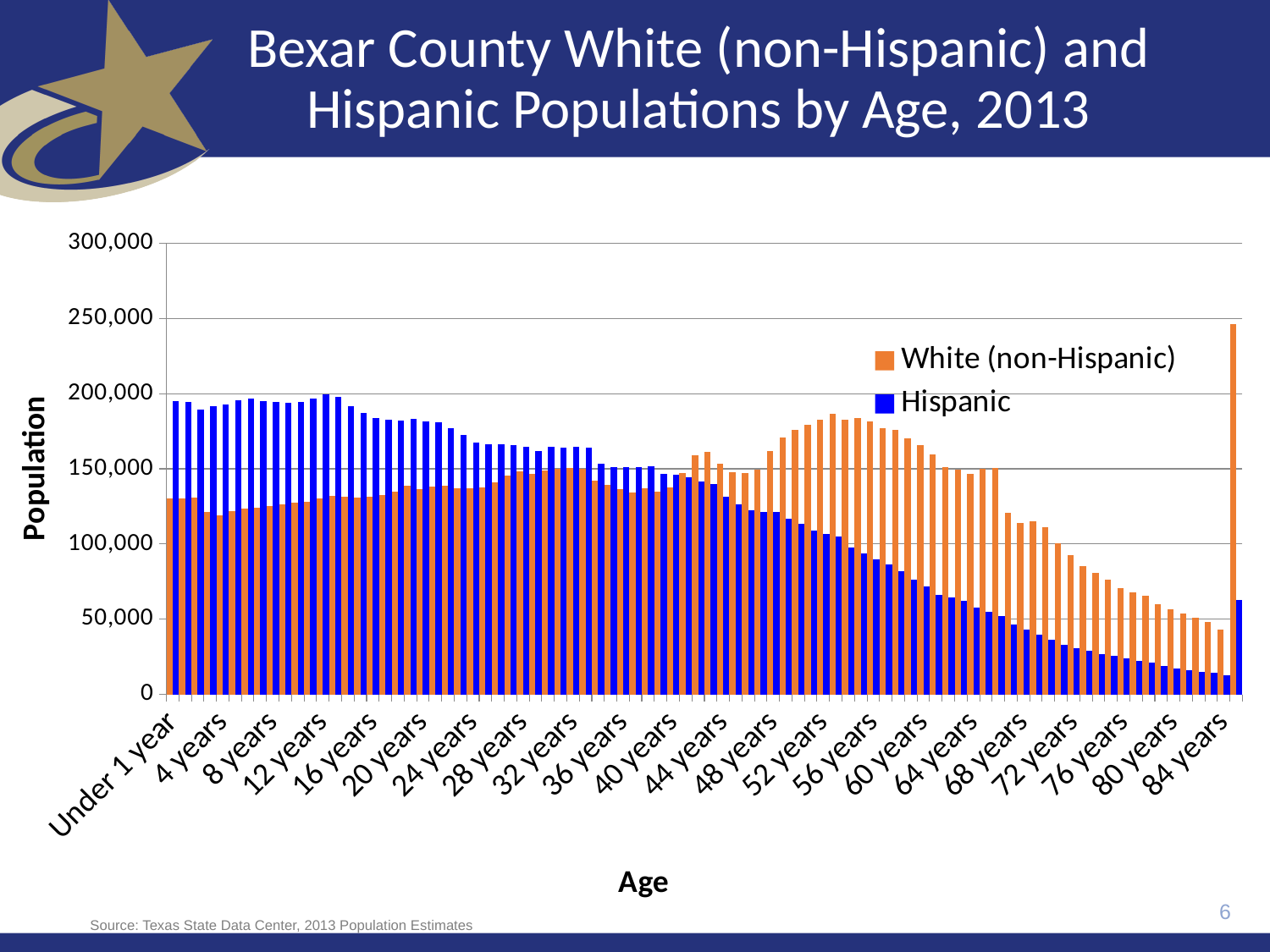
Which series has the tallest bar on the chart? White (non-Hispanic) Which two series are listed in the legend? White (non-Hispanic) and Hispanic Is the Hispanic value for 84 years greater or less than 50,000? less Is the White (non-Hispanic) value for Under 1 year greater or less than 150,000? less Do the Hispanic values generally rise or fall from 16 years to 84 years? fall How many series does the legend list? 2 What is the title of the vertical axis? Population At 4 years, which is larger: the Hispanic population or the White (non-Hispanic) population? Hispanic What kind of chart is shown on the slide? Bar chart At 56 years, which is larger: the Hispanic population or the White (non-Hispanic) population? White (non-Hispanic) Is the Hispanic value for Under 1 year greater or less than 150,000? greater